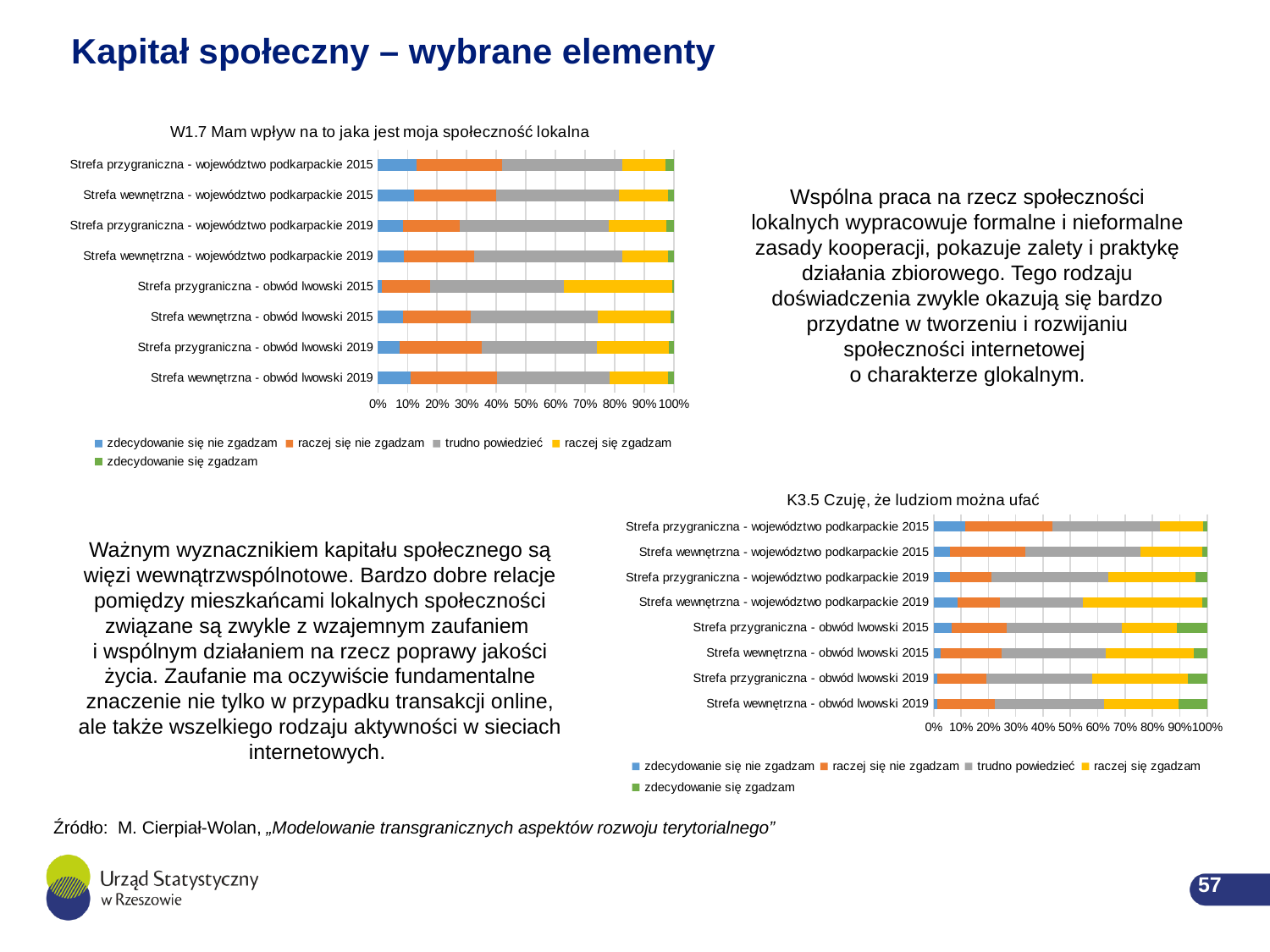
In the chart "W1.7 Mam wpływ na to jaka jest moja społeczność lokalna", is the "raczej się zgadzam" segment larger for "Strefa przygraniczna - obwód lwowski 2015" or for "Strefa przygraniczna - województwo podkarpackie 2019"? Strefa przygraniczna - obwód lwowski 2015 What kind of chart is the chart titled "W1.7 Mam wpływ na to jaka jest moja społeczność lokalna"? Stacked bar chart How many categories (bars) are shown in the chart "K3.5 Czuję, że ludziom można ufać"? 8 In the chart "W1.7 Mam wpływ na to jaka jest moja społeczność lokalna", is the "zdecydowanie się nie zgadzam" share for "Strefa przygraniczna - obwód lwowski 2015" greater or less than 10%? less What kind of chart is the chart titled "K3.5 Czuję, że ludziom można ufać"? Stacked bar chart How many categories (bars) are shown in the chart "W1.7 Mam wpływ na to jaka jest moja społeczność lokalna"? 8 What colour represents the series "trudno powiedzieć" in the chart "K3.5 Czuję, że ludziom można ufać"? Grey In the chart "W1.7 Mam wpływ na to jaka jest moja społeczność lokalna", which category has the largest "raczej się zgadzam" segment? Strefa przygraniczna - obwód lwowski 2015 In the chart "K3.5 Czuję, że ludziom można ufać", is the "zdecydowanie się zgadzam" segment larger for "Strefa wewnętrzna - obwód lwowski 2019" or for "Strefa przygraniczna - województwo podkarpackie 2015"? Strefa wewnętrzna - obwód lwowski 2019 How many series does the legend of the chart "K3.5 Czuję, że ludziom można ufać" list? 5 How many series does the legend of the chart "W1.7 Mam wpływ na to jaka jest moja społeczność lokalna" list? 5 In the chart "K3.5 Czuję, że ludziom można ufać", which category has the largest "zdecydowanie się nie zgadzam" segment? Strefa przygraniczna - województwo podkarpackie 2015